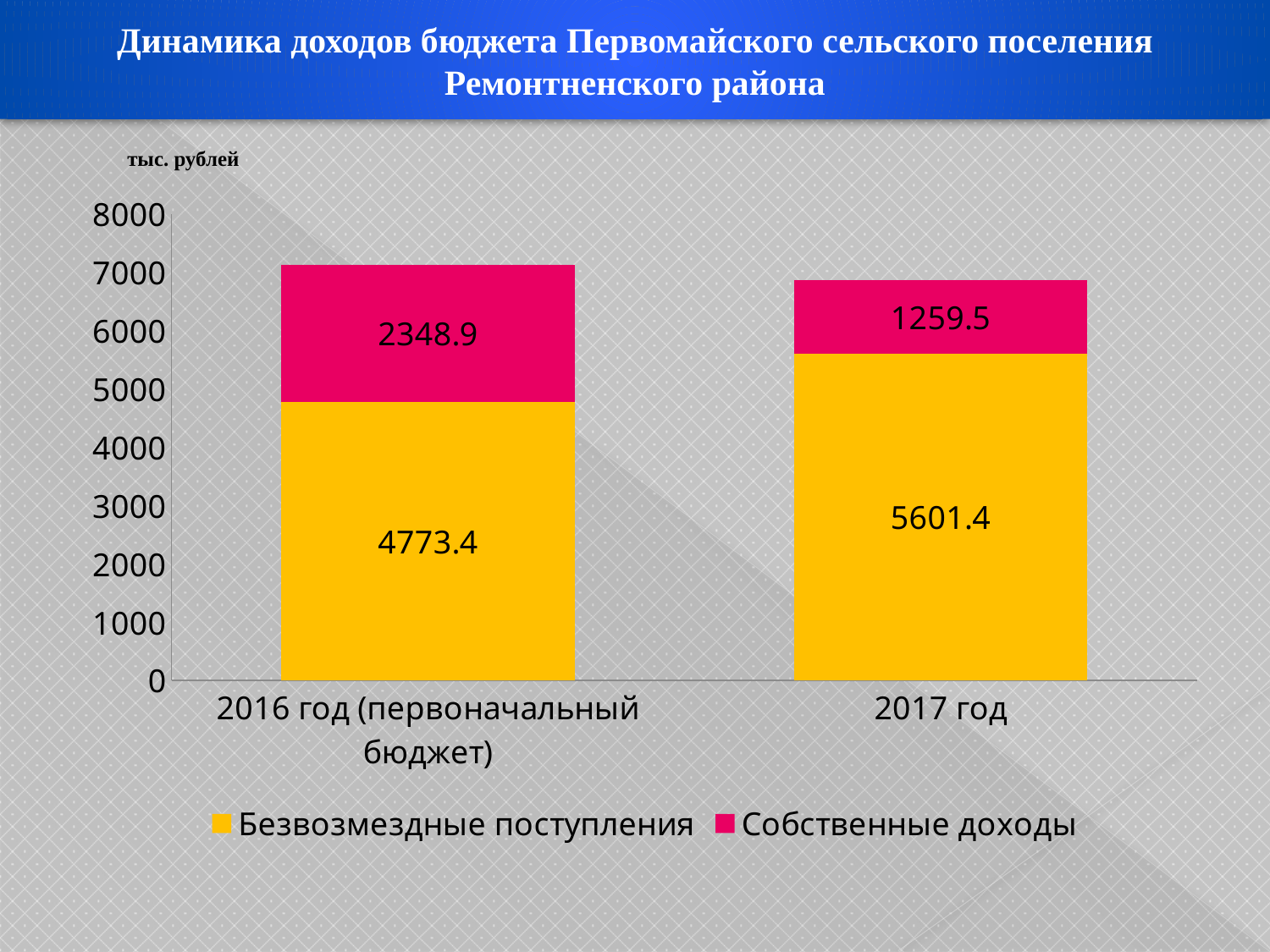
What unit is indicated above the vertical axis of the chart? тыс. рублей How many series does the legend list? 2 What is the value of Безвозмездные поступления for 2017 год? 5601.4 Which year has the larger value for Собственные доходы, 2016 год (первоначальный бюджет) or 2017 год? 2016 год (первоначальный бюджет) What is the value of Собственные доходы for 2017 год? 1259.5 What is the total of the stacked bar for 2017 год? 6860.9 What is the total of the stacked bar for 2016 год (первоначальный бюджет)? 7122.3 What is the difference between Безвозмездные поступления in 2017 год and in 2016 год (первоначальный бюджет)? 828.0 What is the value of Безвозмездные поступления for 2016 год (первоначальный бюджет)? 4773.4 How many categories are shown on the x axis? 2 What is the value of Собственные доходы for 2016 год (первоначальный бюджет)? 2348.9 What type of chart is shown on the slide? Stacked bar chart